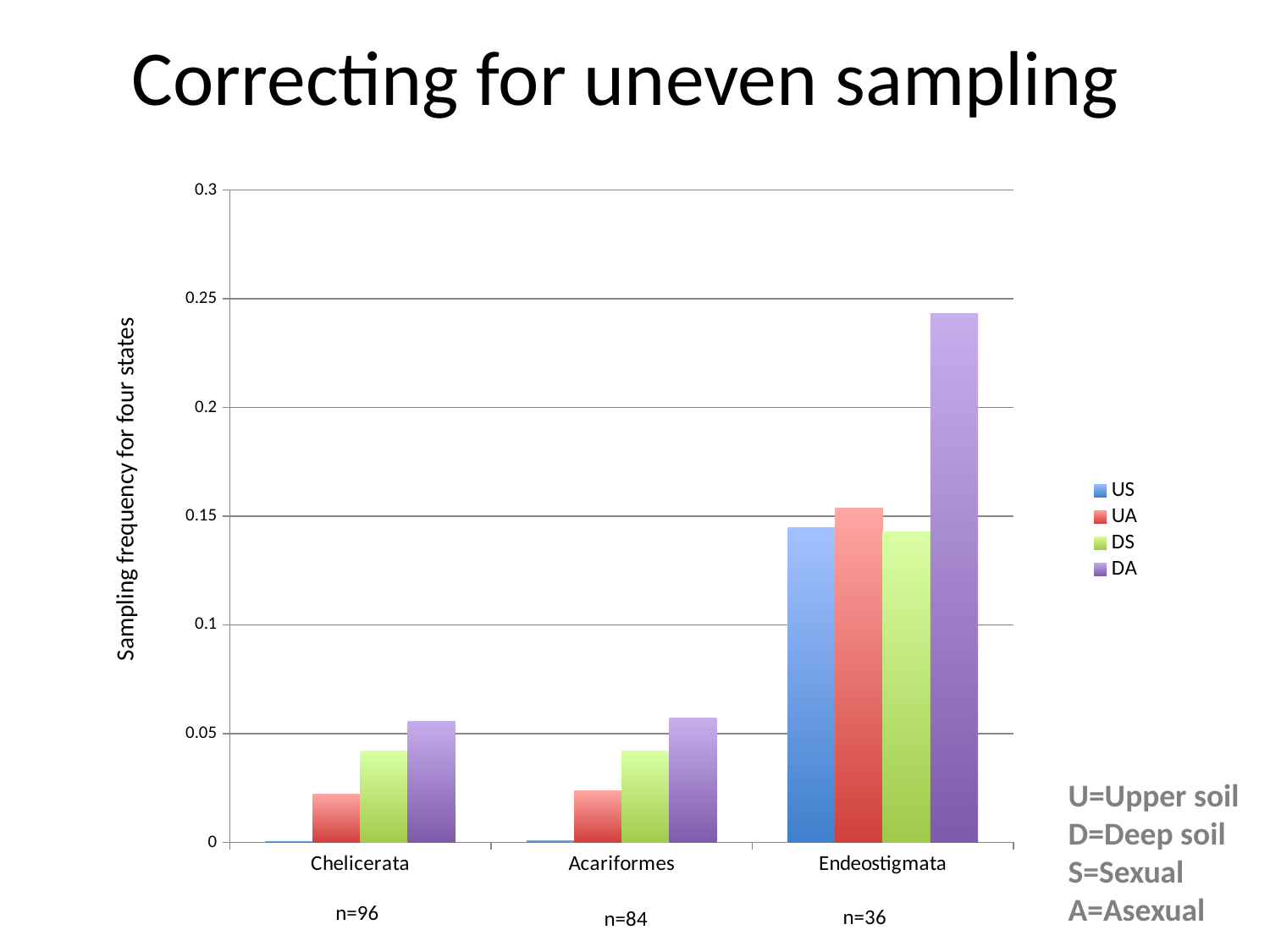
How many series does the legend list? 4 What kind of chart is shown on the slide? bar chart Which series has the lowest value for Chelicerata? US What is the title of the slide? Correcting for uneven sampling Is the DA value for Endeostigmata greater or less than 0.2? greater Is the US value for Endeostigmata greater or less than 0.1? greater Which series has the highest value for Endeostigmata? DA Is the DA value for Chelicerata greater or less than 0.1? less Which category has the highest DA value? Endeostigmata What is the label on the y axis? Sampling frequency for four states How many categories are shown on the x axis? 3 Which is larger for Acariformes, the UA value or the DS value? DS